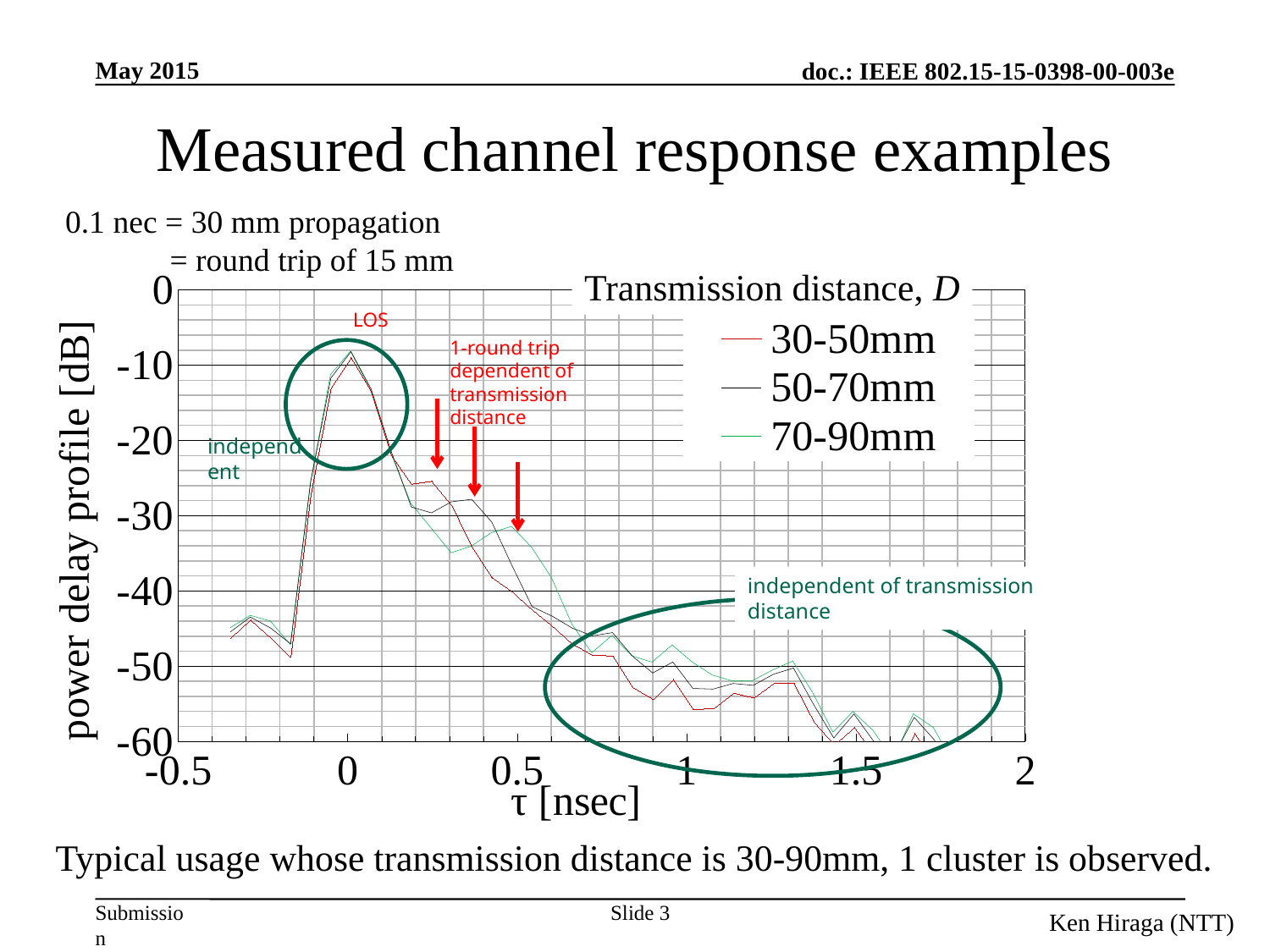
What is the maximum value shown on the x axis? 2 How many series does the legend list? 3 Do the plotted values rise or fall along the x axis between τ = 0 and τ = 2 nsec? fall Is the value of the 70-90mm series at τ = 0.5 nsec greater or less than -40 dB? greater Is the peak value of the 30-50mm series at τ = 0 greater or less than -20 dB? greater Is the value of the 30-50mm series at τ = -0.2 nsec greater or less than -40 dB? less What is the label of the x axis? τ [nsec] What kind of chart is shown on the slide? line chart What are the three series listed in the legend? 30-50mm, 50-70mm, 70-90mm